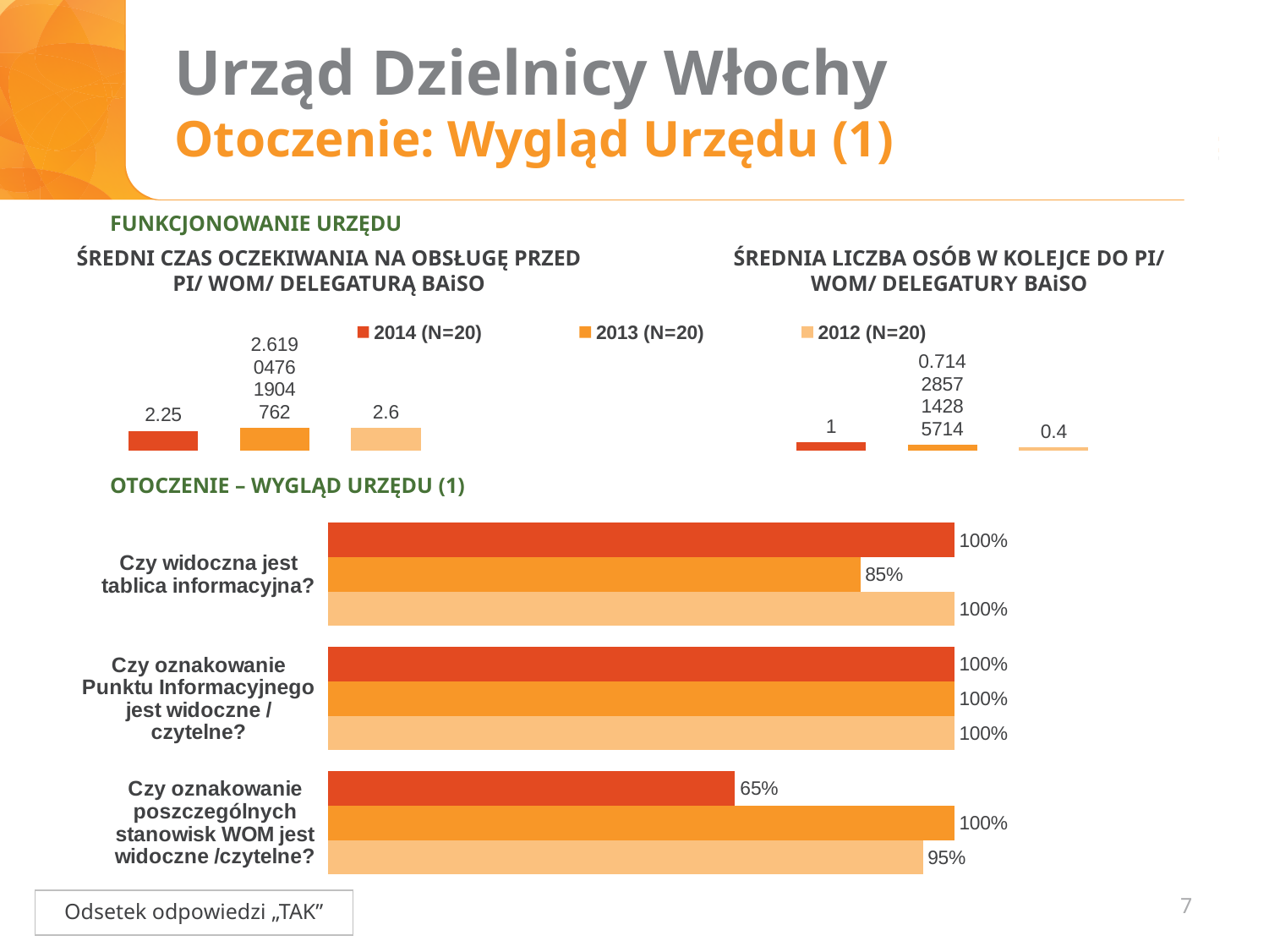
In the chart 'ŚREDNI CZAS OCZEKIWANIA NA OBSŁUGĘ PRZED PI/ WOM/ DELEGATURĄ BAiSO', what is the value for 2012 (N=20)? 2.6 In the chart 'ŚREDNIA LICZBA OSÓB W KOLEJCE DO PI/ WOM/ DELEGATURY BAiSO', what is the difference between the 2014 and 2012 values? 0.6 What kind of chart is 'OTOCZENIE – WYGLĄD URZĘDU (1)'? Bar chart In the bottom chart 'OTOCZENIE – WYGLĄD URZĘDU (1)', what is the 2013 (N=20) value for 'Czy widoczna jest tablica informacyjna?'? 85% In the bottom chart 'OTOCZENIE – WYGLĄD URZĘDU (1)', what is the 2012 (N=20) value for 'Czy oznakowanie poszczególnych stanowisk WOM jest widoczne /czytelne?'? 95% How many series does the legend list for the charts on this slide? 3 In the bottom chart 'OTOCZENIE – WYGLĄD URZĘDU (1)', what is the difference between the 2013 and 2014 values for 'Czy oznakowanie poszczególnych stanowisk WOM jest widoczne /czytelne?'? 35% In the chart 'ŚREDNIA LICZBA OSÓB W KOLEJCE DO PI/ WOM/ DELEGATURY BAiSO', what is the value for 2014 (N=20)? 1 In the chart 'ŚREDNI CZAS OCZEKIWANIA NA OBSŁUGĘ PRZED PI/ WOM/ DELEGATURĄ BAiSO', what is the value for 2014 (N=20)? 2.25 In the chart 'ŚREDNIA LICZBA OSÓB W KOLEJCE DO PI/ WOM/ DELEGATURY BAiSO', what is the value for 2012 (N=20)? 0.4 In the chart 'ŚREDNIA LICZBA OSÓB W KOLEJCE DO PI/ WOM/ DELEGATURY BAiSO', which year has the lowest value? 2012 (N=20) In the bottom chart 'OTOCZENIE – WYGLĄD URZĘDU (1)', what is the 2014 (N=20) value for 'Czy oznakowanie poszczególnych stanowisk WOM jest widoczne /czytelne?'? 65%